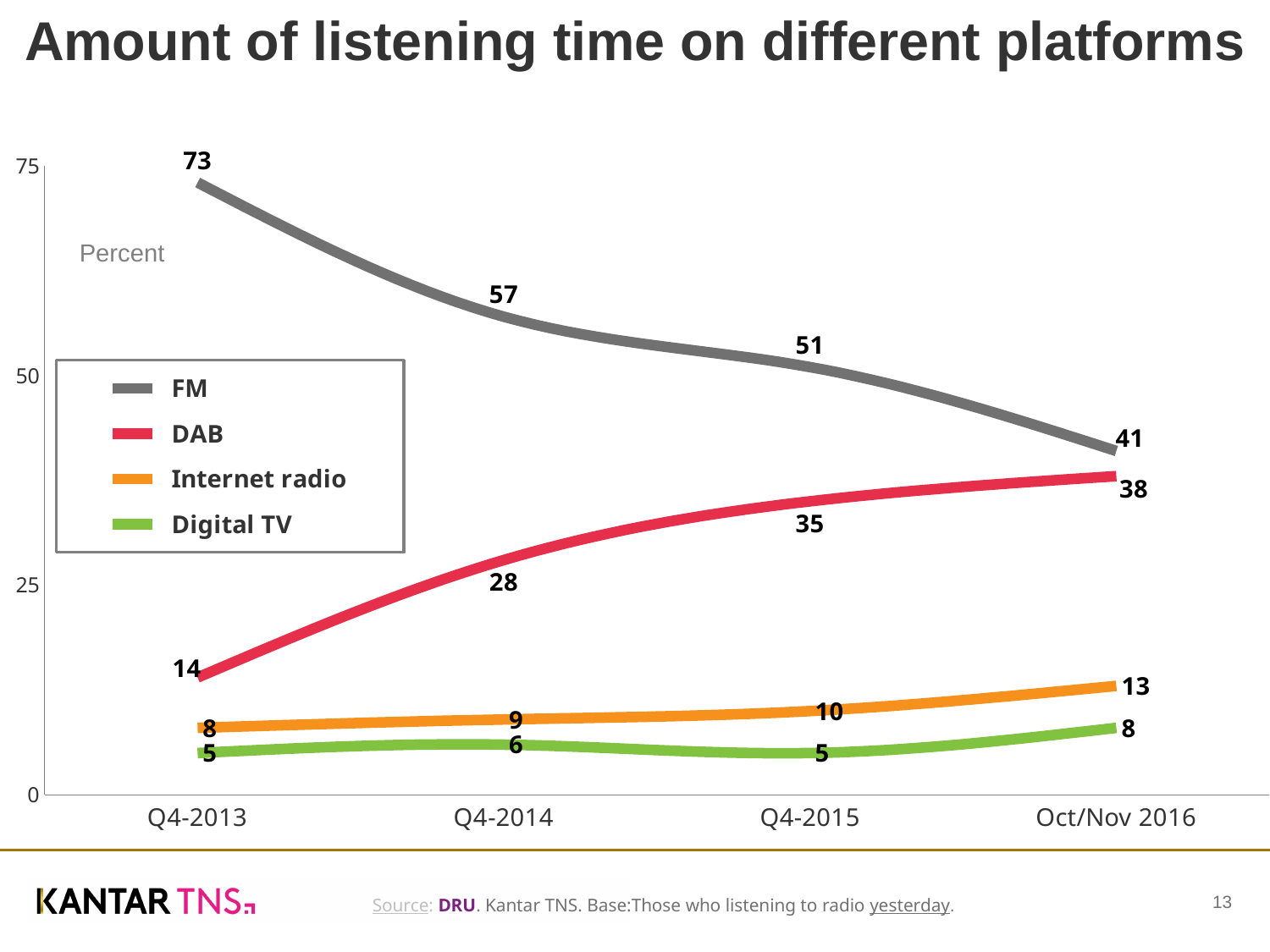
What kind of chart is shown on the slide? Line chart What is the Digital TV value for Q4-2014? 6 Does the DAB series rise or fall from Q4-2013 to Oct/Nov 2016? Rise What is the FM value for Q4-2013? 73 What is the DAB value for Oct/Nov 2016? 38 What is the Internet radio value for Q4-2015? 10 What is the difference between the FM and DAB values in Oct/Nov 2016? 3 By how much did the FM value fall from Q4-2013 to Oct/Nov 2016? 32 In which period is the FM value lowest? Oct/Nov 2016 Which is larger in Q4-2014, the FM value or the DAB value? FM How many series does the legend list? 4 In which period is the DAB value highest? Oct/Nov 2016